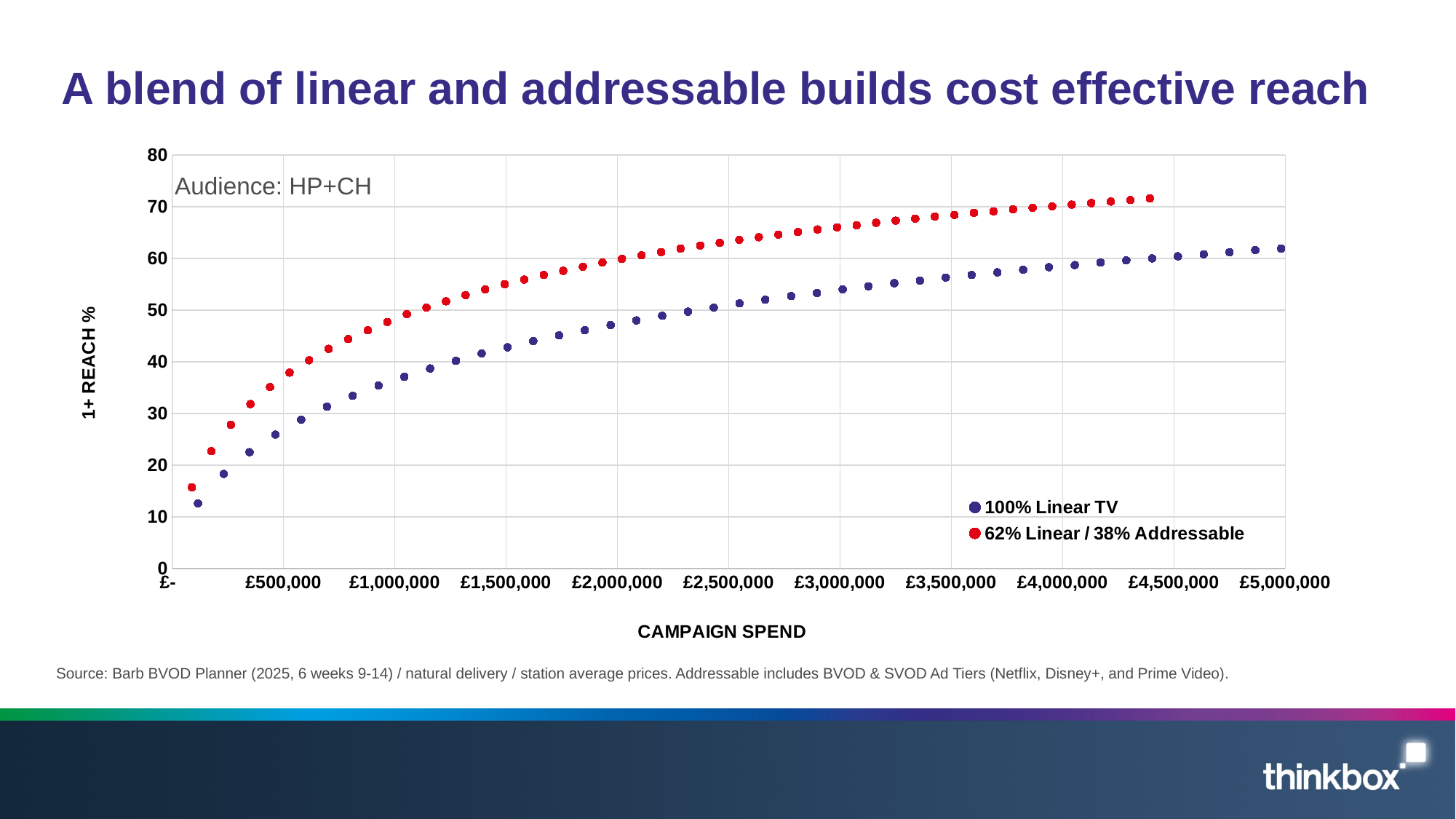
At a campaign spend of £2,500,000, which series has the higher 1+ reach %? 62% Linear / 38% Addressable Which series reaches the higher 1+ reach % overall? 62% Linear / 38% Addressable What are the two series named in the legend? 100% Linear TV; 62% Linear / 38% Addressable How many series does the legend list? 2 Is the 1+ reach % for 100% Linear TV at £4,000,000 campaign spend greater or less than 60? less What kind of chart is shown on the slide? Scatter chart Is the 1+ reach % for 100% Linear TV at £2,000,000 campaign spend greater or less than 50? less Is the 1+ reach % for 100% Linear TV at £5,000,000 campaign spend greater or less than 60? greater Do the values for 100% Linear TV rise or fall as campaign spend increases? Rise What is the label of the y axis? 1+ REACH %